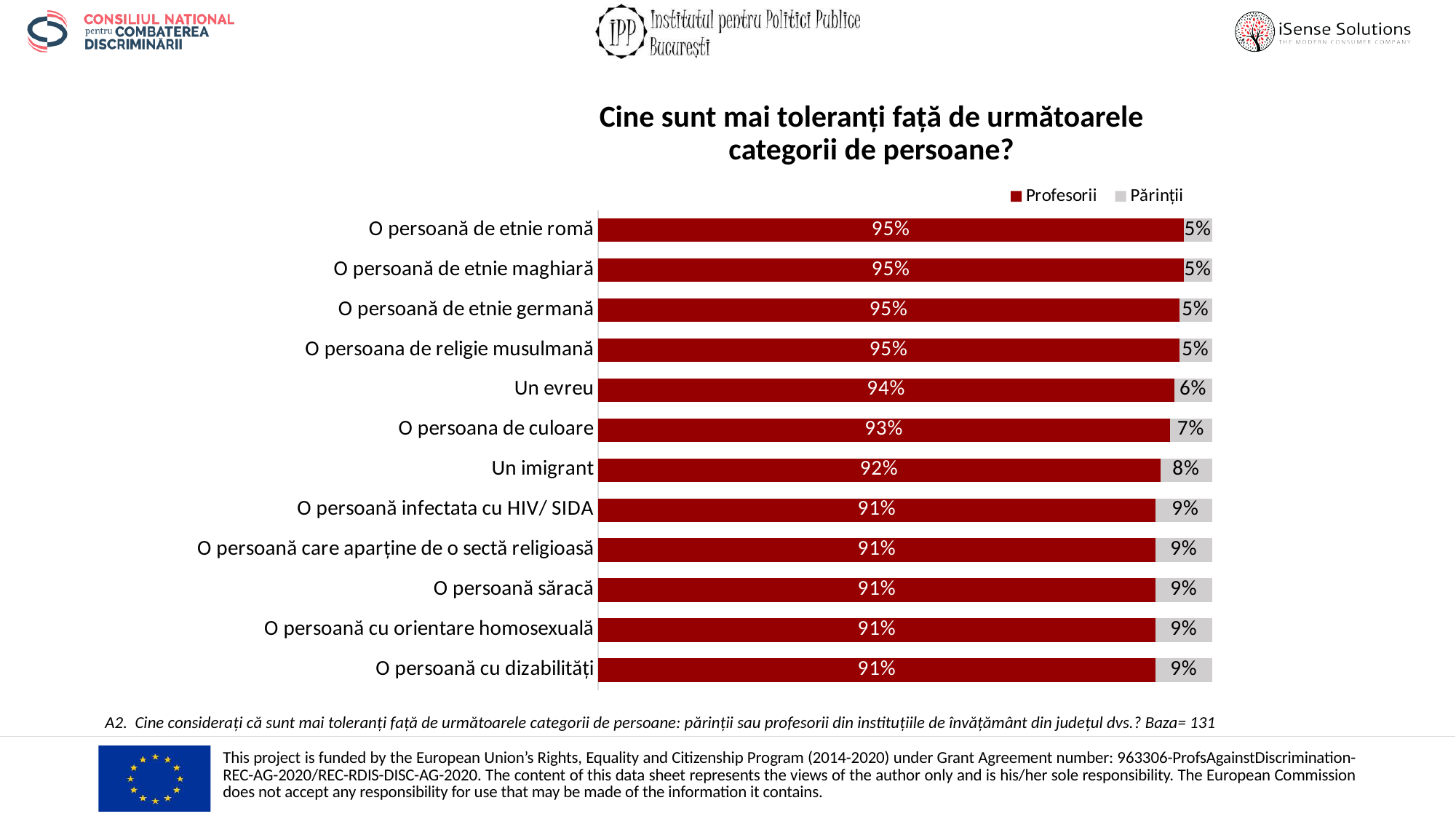
Which series is shown in dark red in the legend? Profesorii What is the Profesorii value for "O persoana de culoare"? 93% What is the Părinții value for "O persoană cu dizabilități"? 9% How many series does the legend list? 2 What is the Părinții value for "Un imigrant"? 8% Which is larger: the Profesorii value for "Un evreu" or for "Un imigrant"? Un evreu What kind of chart is shown on the slide? bar chart What is the Profesorii value for "Un evreu"? 94% How many categories of persons are shown in the chart? 12 Which category has the highest Părinții value? O persoană infectata cu HIV/ SIDA, O persoană care aparține de o sectă religioasă, O persoană săracă, O persoană cu orientare homosexuală, O persoană cu dizabilități (all 9%) What is the total of the stacked bar for "O persoană infectata cu HIV/ SIDA"? 100% What is the difference between the Profesorii values for "O persoană de etnie romă" and "O persoană săracă"? 4%